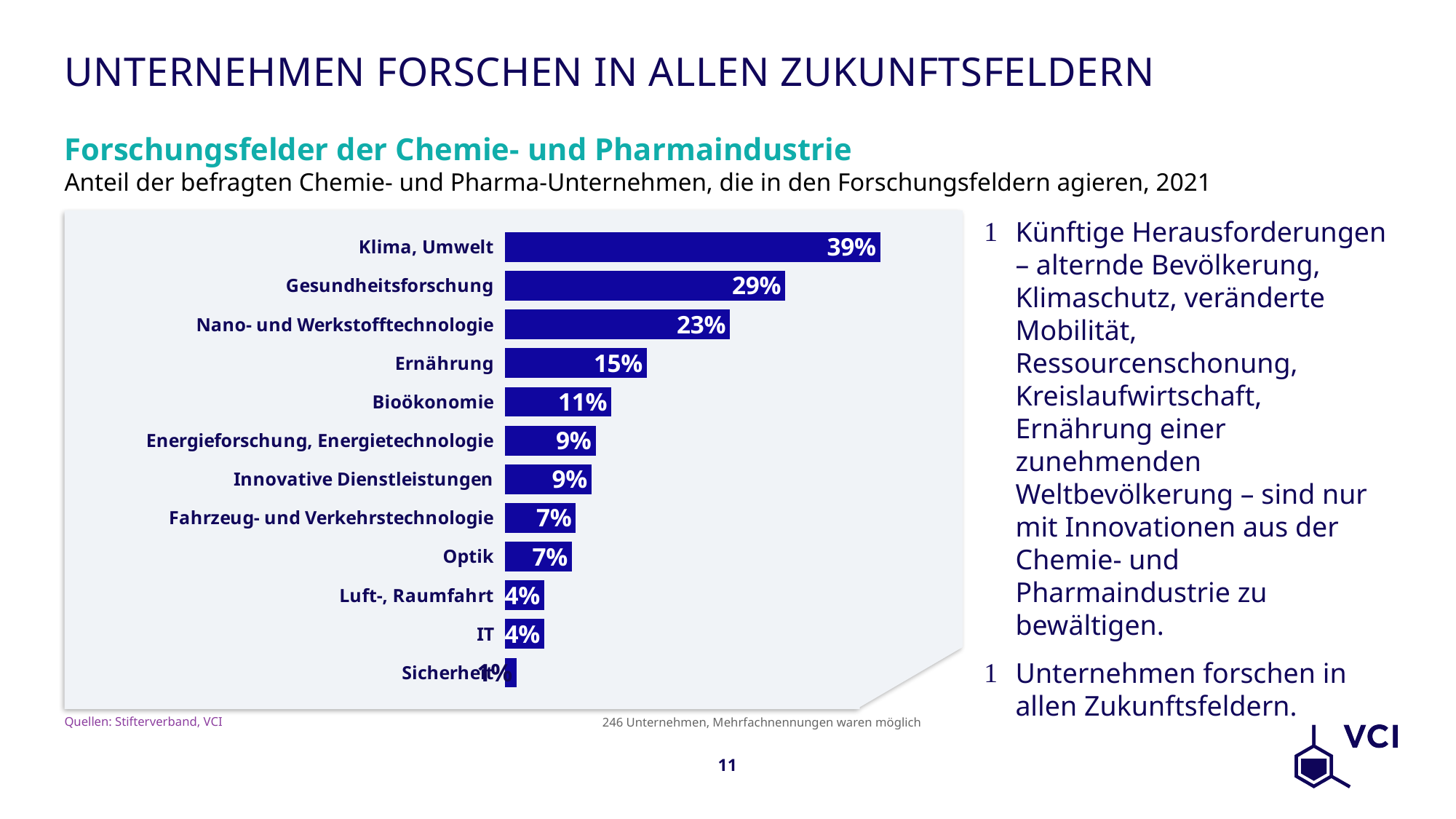
Which is larger, the value for Ernährung or the value for Optik? Ernährung What is the value for Luft-, Raumfahrt? 4% What is the value for Bioökonomie? 11% What is the title of the chart? Forschungsfelder der Chemie- und Pharmaindustrie What is the value for Nano- und Werkstofftechnologie? 23% Which research field has the highest share? Klima, Umwelt What is the value for Klima, Umwelt? 39% What is the difference between the values for Klima, Umwelt and Gesundheitsforschung? 10% How many research fields are shown in the chart? 12 What kind of chart is shown on the slide? Bar chart What is the value for Gesundheitsforschung? 29% Which research field has the lowest share? Sicherheit